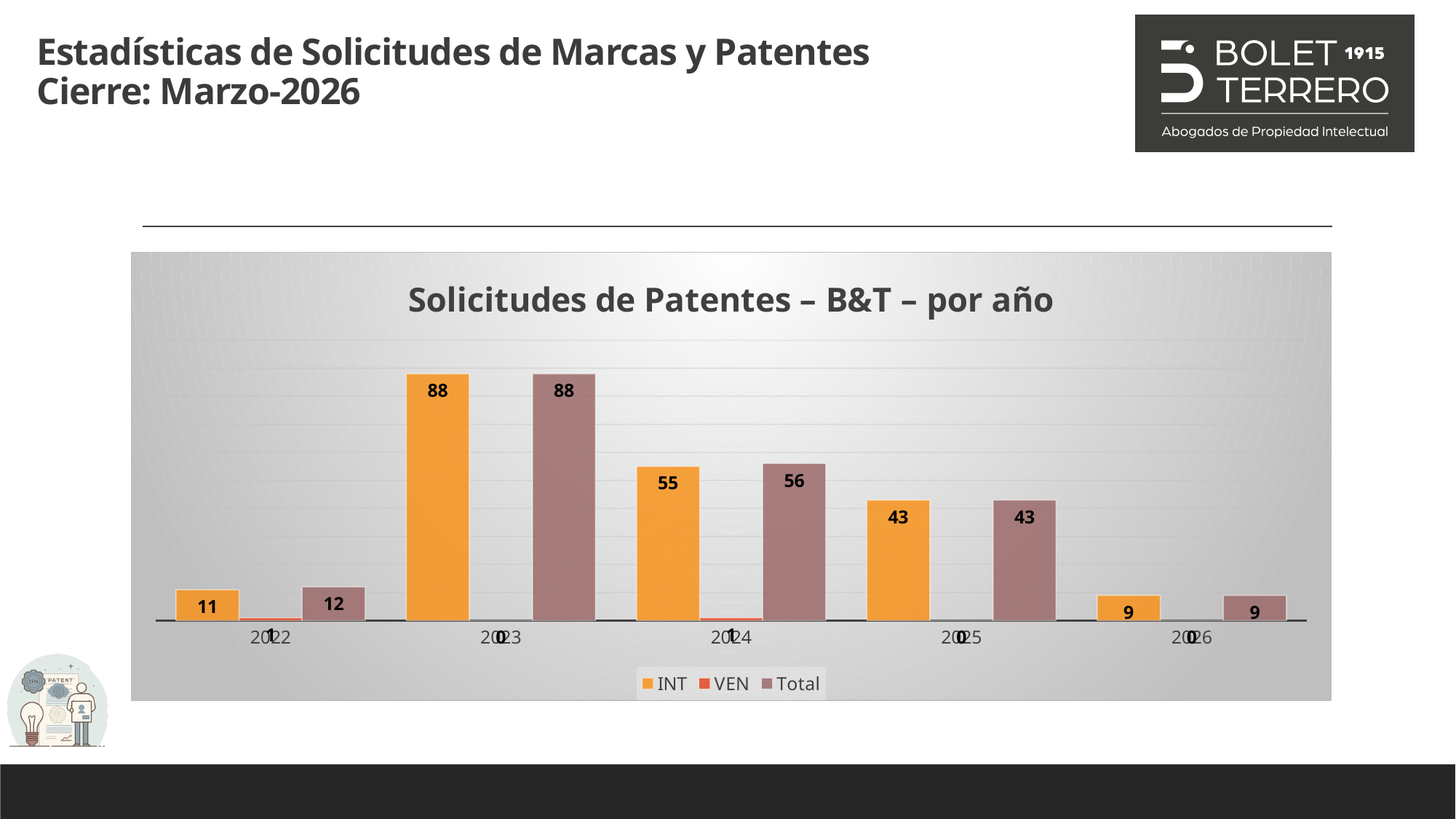
What is the Total value for 2022? 12 What kind of chart is shown on the slide? Bar chart What is the Total value for 2024? 56 How many years are shown on the x axis? 5 Which is larger, the INT value for 2024 or the INT value for 2025? 2024 What is the INT value for 2023? 88 What is the difference between the Total value and the INT value for 2022? 1 Which year has the lowest Total value? 2026 What is the INT value for 2026? 9 Which year has the highest INT value? 2023 How many series does the legend list? 3 What is the difference between the INT values for 2023 and 2024? 33